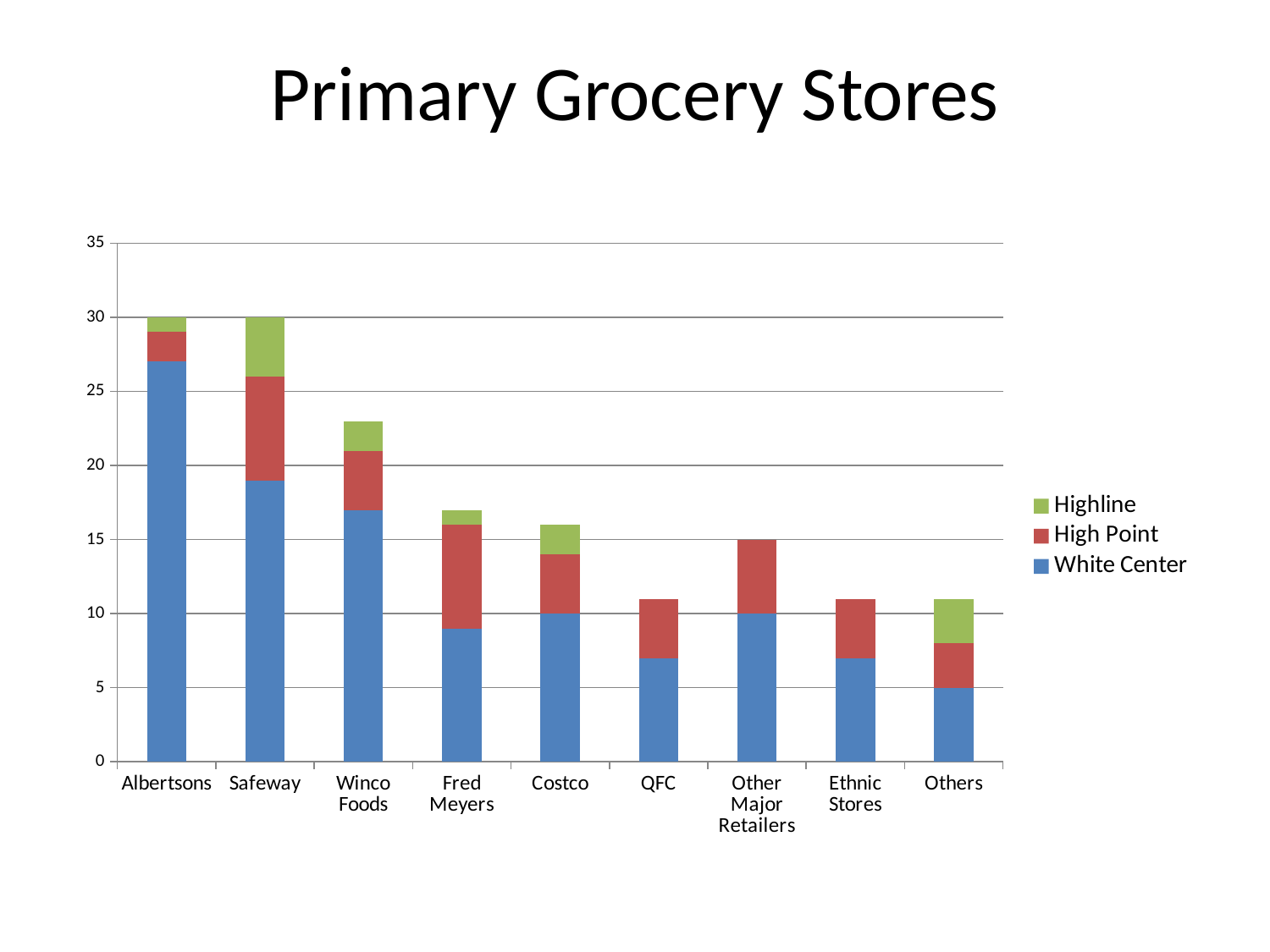
Is the White Center value for Albertsons greater or less than 25? greater Which store has the highest White Center value? Albertsons What is the White Center value for Costco? 10 How many store categories are shown on the x axis? 9 What kind of chart is shown on the slide? Stacked bar chart Which has the larger total bar, Other Major Retailers or QFC? Other Major Retailers How many series does the legend list? 3 Which series is shown in green in the legend? Highline What is the title of the chart? Primary Grocery Stores What is the total height of the stacked bar for Other Major Retailers? 15 What is the total height of the stacked bar for Safeway? 30 Which store has the lowest White Center value? Others